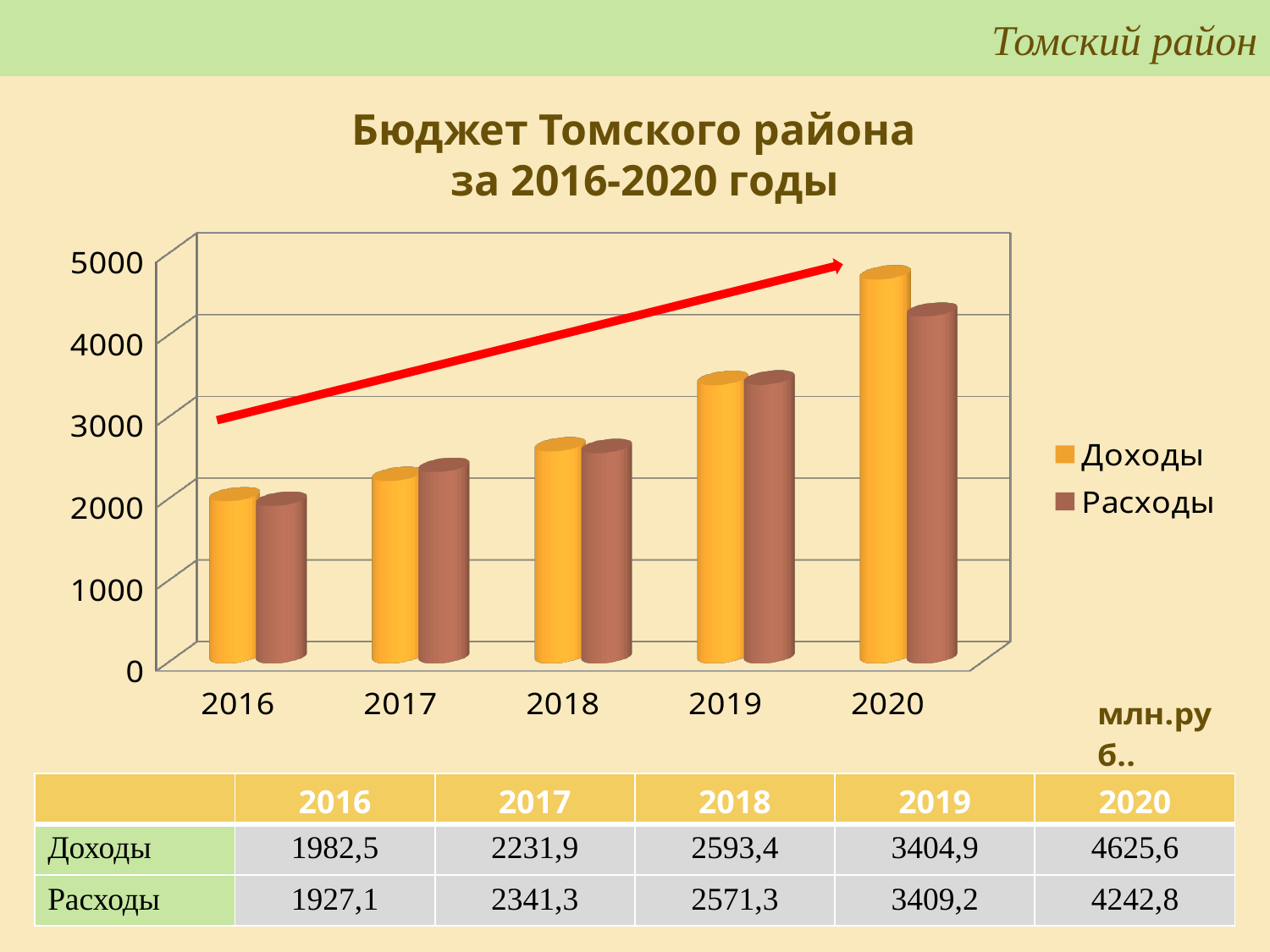
Is the value of Доходы for 2019 greater or less than 3000? greater What is the value of Расходы for 2017? 2341,3 How many series does the legend list? 2 In 2017, which is larger: Доходы or Расходы? Расходы What is the difference between Доходы and Расходы in 2020? 382,8 In which year are Доходы the highest? 2020 Do the Доходы values rise or fall from 2016 to 2020? rise What is the value of Доходы for 2020? 4625,6 How many years are shown on the x axis of the chart? 5 In which year are Расходы the lowest? 2016 What is the title of the chart? Бюджет Томского района за 2016-2020 годы What kind of chart is shown on the slide? bar chart